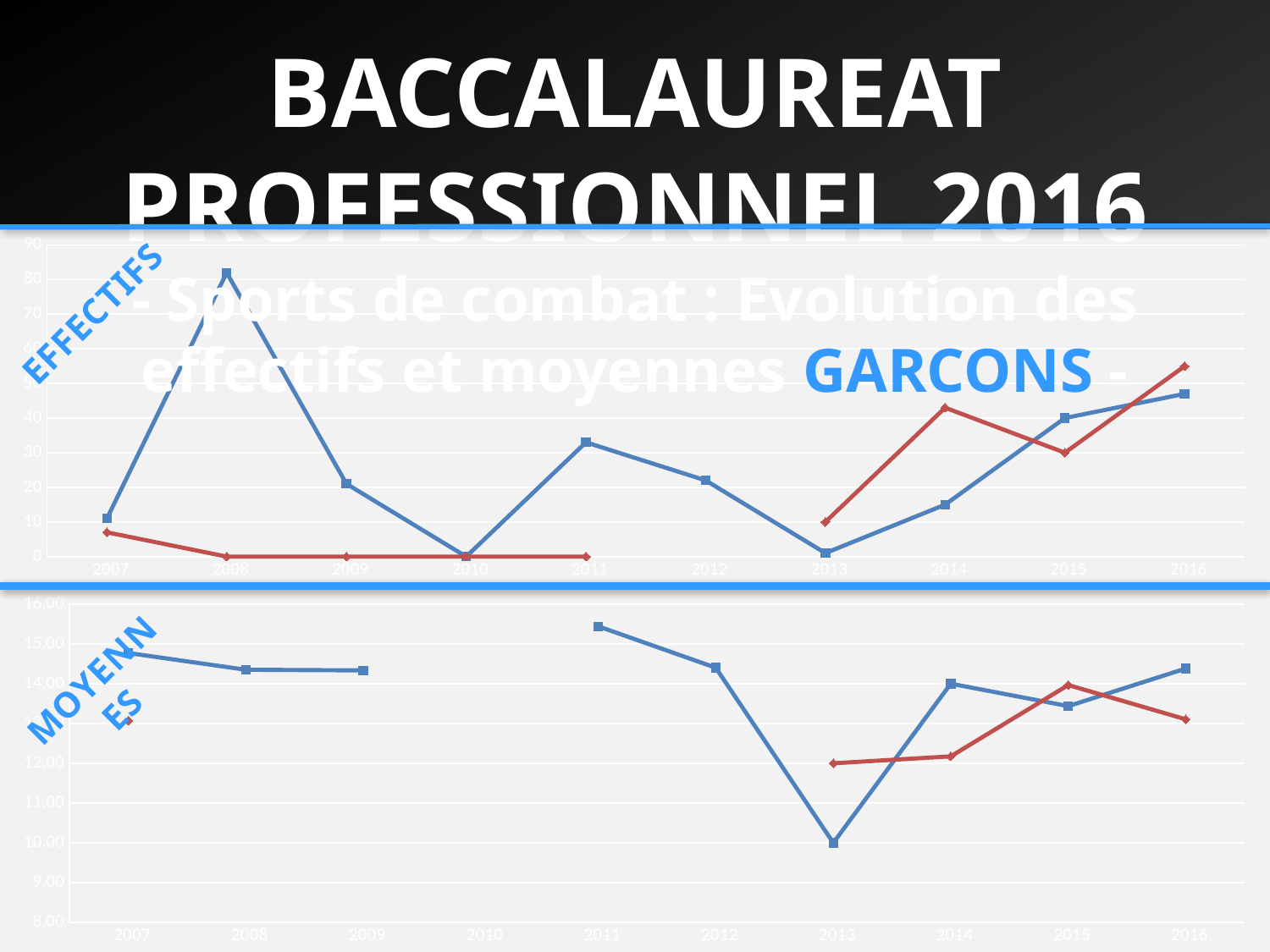
In the top chart (EFFECTIFS), is the red line's value for 2016 greater or less than 50? greater In the top chart (EFFECTIFS), is the red line's value for 2014 greater or less than 40? greater In the top chart (EFFECTIFS), does the blue line rise or fall from 2013 to 2016? rise In the top chart (EFFECTIFS), in which year does the blue line reach its highest value? 2008 How many years are shown on the x axis of the bottom chart (MOYENNES)? 10 What kind of chart is the top chart (EFFECTIFS)? line chart In the bottom chart (MOYENNES), is the blue line's value for 2011 greater or less than 15.00? greater In the top chart (EFFECTIFS), which line is higher in 2015, the red line or the blue line? blue line In the bottom chart (MOYENNES), in which year does the blue line reach its lowest value? 2013 What kind of chart is the bottom chart (MOYENNES)? line chart In the top chart (EFFECTIFS), which line is higher in 2016, the red line or the blue line? red line